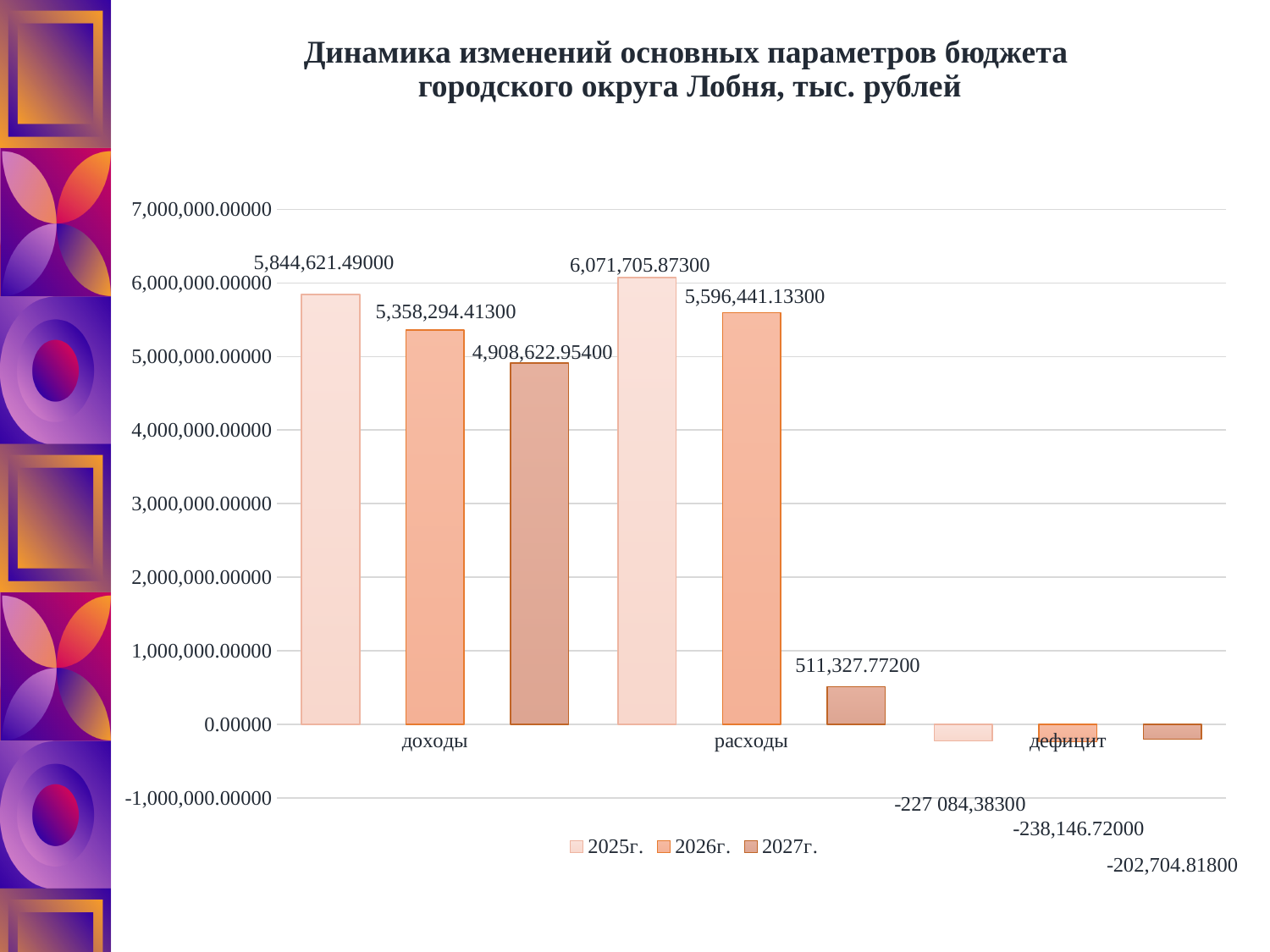
Which series has the lowest value for доходы? 2027г. Is the 2027г. value for доходы greater or less than 5,000,000.00000? less How many series does the legend list? 3 What is the difference between the 2025г. and 2026г. values for доходы? 486,327.07700 What is the value for расходы in the 2026г. series? 5,596,441.13300 What is the value for дефицит in the 2027г. series? -202,704.81800 What kind of chart is shown on the slide? bar chart What is the value for доходы in the 2025г. series? 5,844,621.49000 Which series has the highest value for расходы? 2025г. How many categories are shown on the x axis? 3 What is the value for расходы in the 2027г. series? 511,327.77200 Which is larger for 2026г.: доходы or расходы? расходы